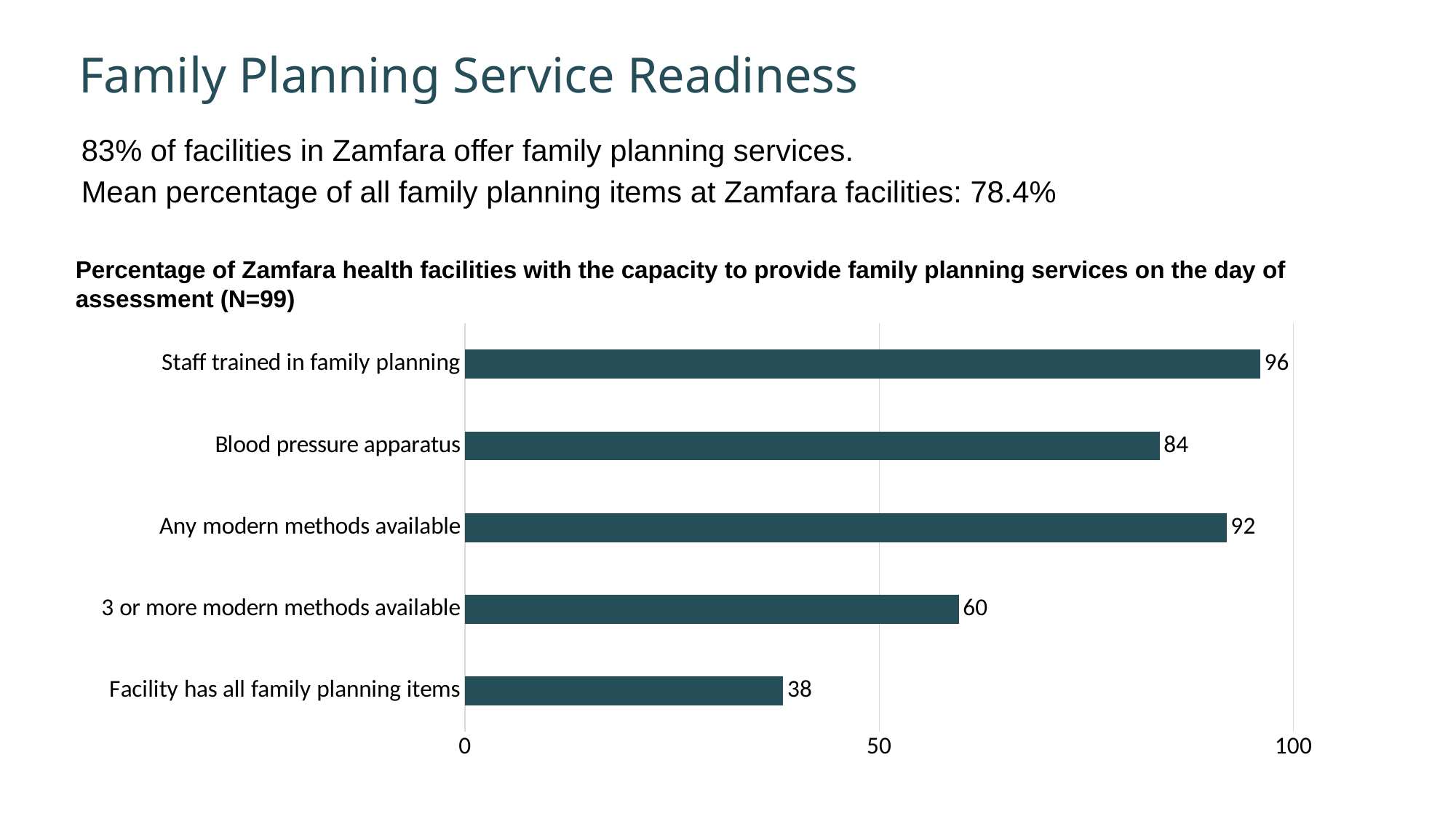
What is the difference between the values for Any modern methods available and 3 or more modern methods available? 32 What is the value for Blood pressure apparatus? 84 What is the value for Staff trained in family planning? 96 How many categories are shown in the chart? 5 What is the sample size (N) stated in the chart title? N=99 Which is larger, the value for Blood pressure apparatus or the value for Any modern methods available? Any modern methods available What is the difference between the values for Staff trained in family planning and Facility has all family planning items? 58 What kind of chart is shown on the slide? Bar chart Which category has the lowest value? Facility has all family planning items Which category has the highest value? Staff trained in family planning What is the value for Facility has all family planning items? 38 Is the value for 3 or more modern methods available greater or less than 50? greater